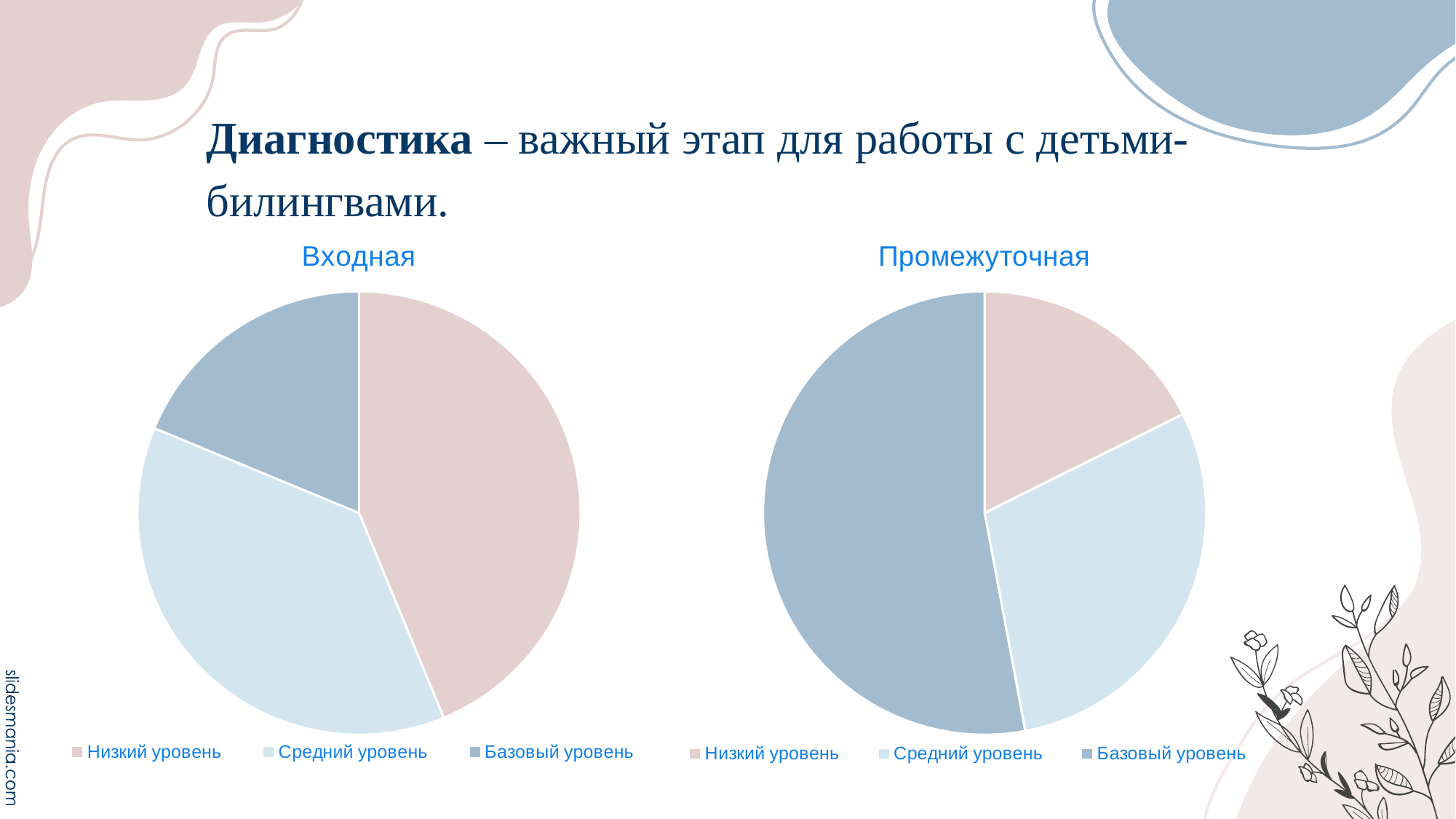
What kind of chart is the "Промежуточная" chart? pie chart In the "Входная" chart, which category has the smallest slice? Базовый уровень In the "Входная" chart, which slice is larger: Средний уровень or Базовый уровень? Средний уровень How many entries does the legend of the "Промежуточная" chart list? 3 In the "Промежуточная" chart, which colour represents Низкий уровень? pink In the "Промежуточная" chart, which category has the smallest slice? Низкий уровень What kind of chart is the "Входная" chart? pie chart In the "Промежуточная" chart, which slice is larger: Низкий уровень or Средний уровень? Средний уровень In the "Промежуточная" chart, which category has the largest slice? Базовый уровень In the "Входная" chart, which category has the largest slice? Низкий уровень How many slices does the "Входная" pie chart have? 3 What is the title of the pie chart on the left of the slide? Входная